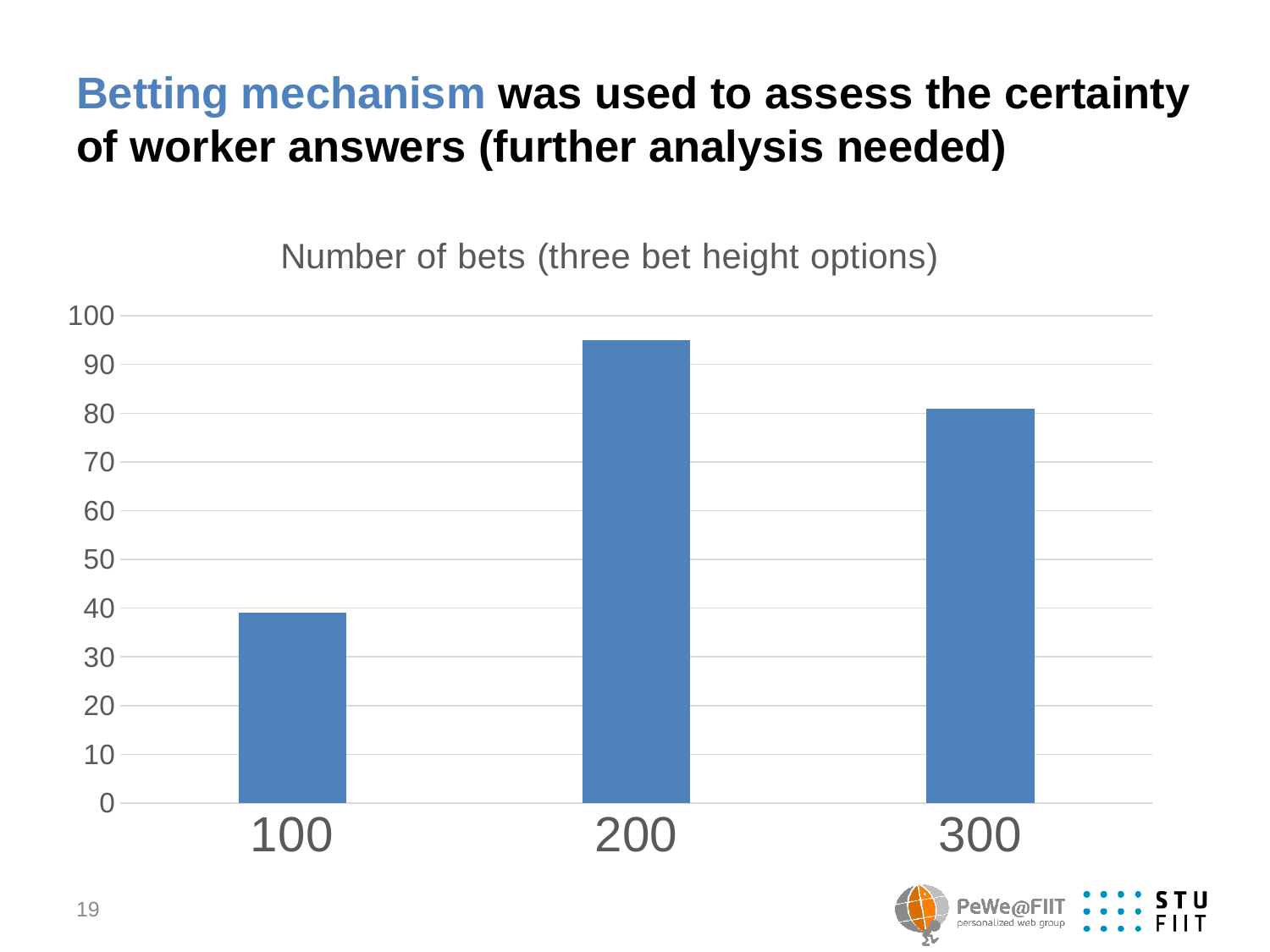
How many categories are shown on the x axis of the chart? 3 Is the value for 100 greater or less than 50? less Is the value for 300 greater or less than 70? greater What is the title of the chart? Number of bets (three bet height options) Does the number of bets rise or fall from the 100 option to the 200 option? rise Which bet height option has the lowest number of bets? 100 Is the value for 200 greater or less than 90? greater Which has more bets, the 100 option or the 300 option? 300 Which has more bets, the 200 option or the 300 option? 200 Which bet height option has the highest number of bets? 200 What kind of chart is shown on the slide? bar chart